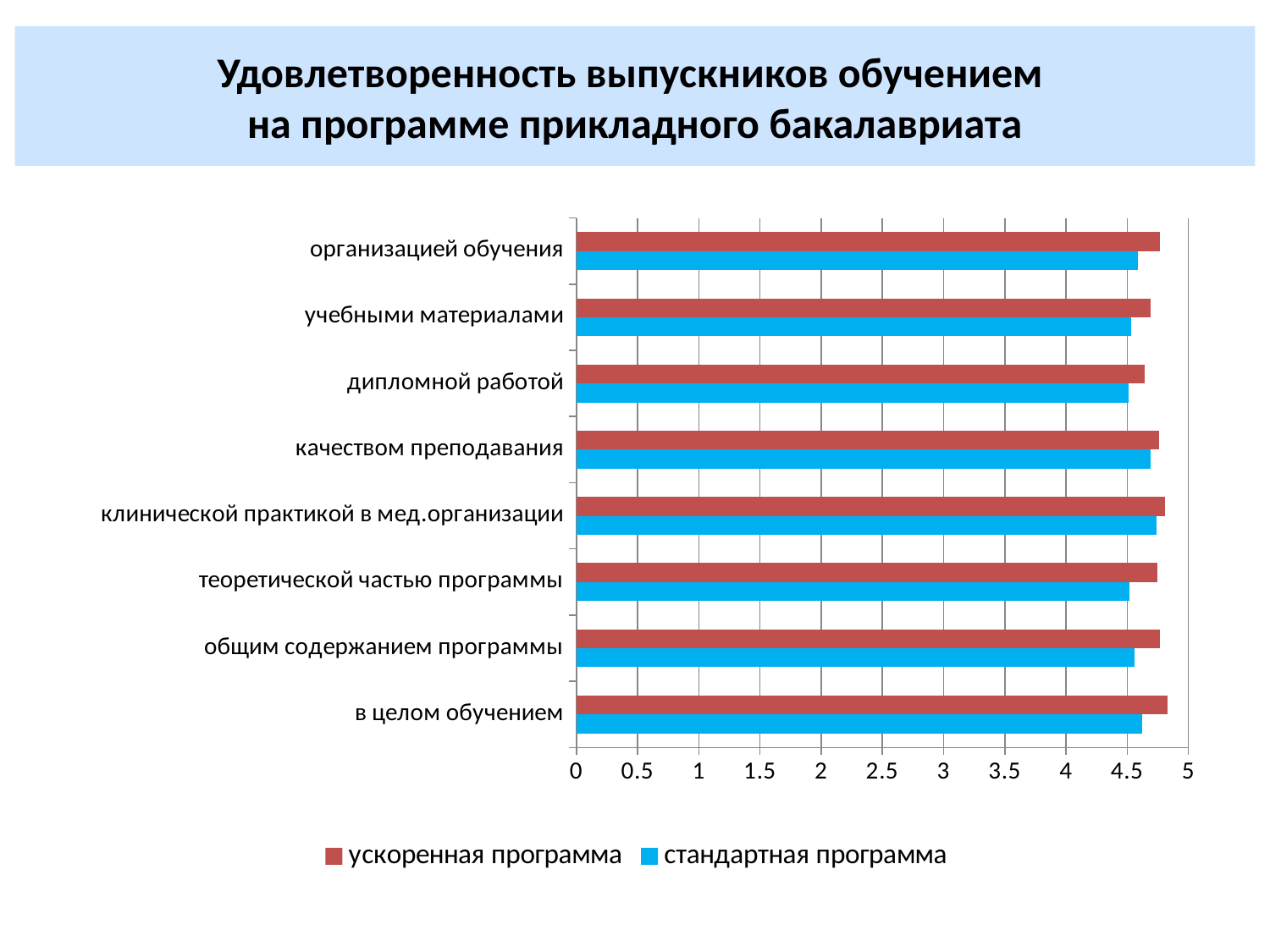
For the category 'в целом обучением', which series has the larger value: 'ускоренная программа' or 'стандартная программа'? ускоренная программа What kind of chart is shown on the slide? bar chart Is the value for 'стандартная программа' in the category 'качеством преподавания' greater or less than 4.5? greater How many series does the legend list? 2 For the category 'теоретической частью программы', which series has the larger value: 'ускоренная программа' or 'стандартная программа'? ускоренная программа Is the value for 'стандартная программа' in the category 'клинической практикой в мед.организации' greater or less than 4.5? greater Is the value for 'ускоренная программа' in the category 'в целом обучением' greater or less than 4.5? greater How many categories are shown on the vertical axis of the chart? 8 Which series is shown in red in the chart? ускоренная программа What is the title of the slide containing the chart? Удовлетворенность выпускников обучением на программе прикладного бакалавриата